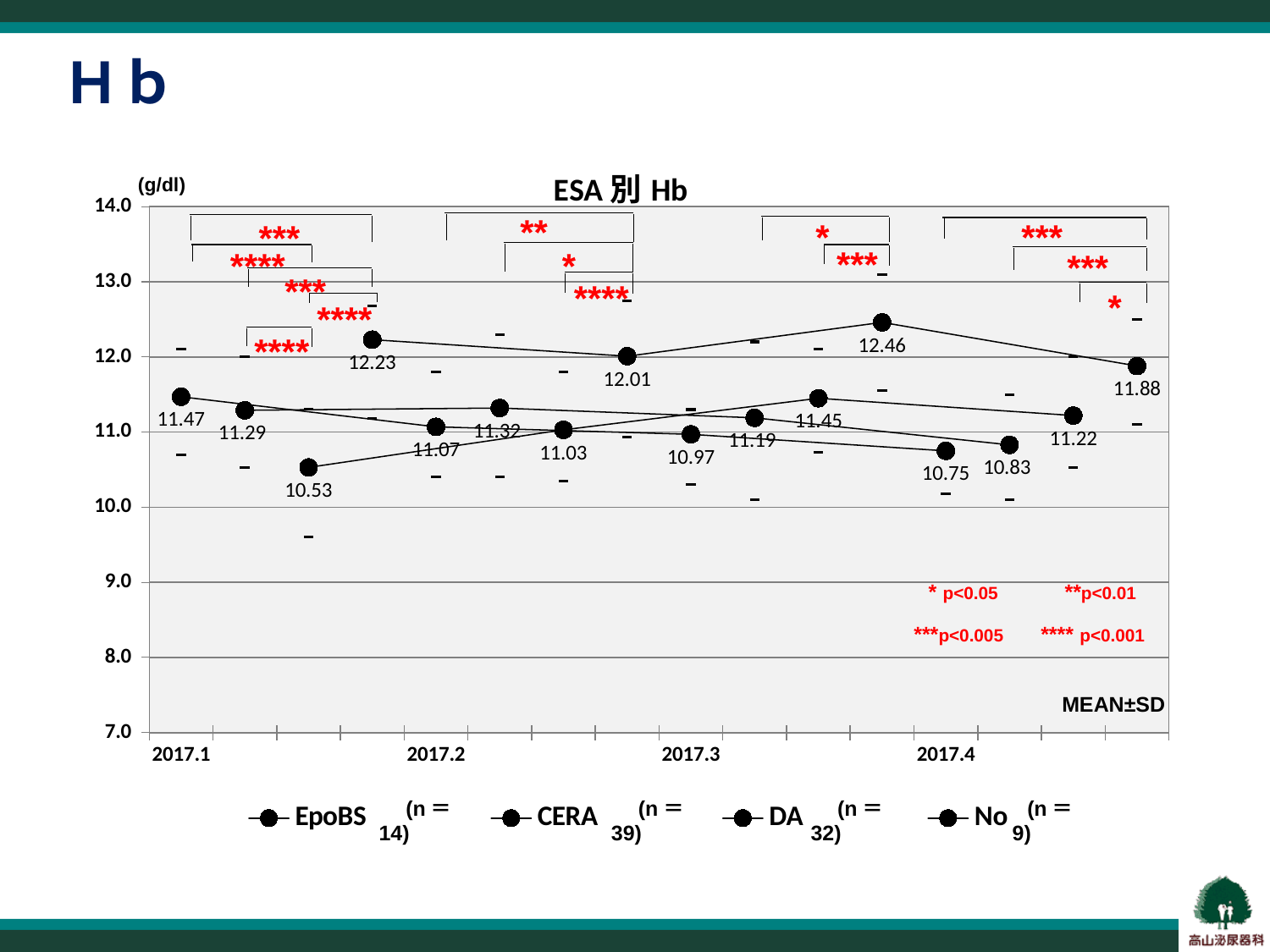
Does the topmost line rise or fall from 2017.3 to 2017.4? fall Is the lowest labelled value in the 2017.1 period greater or less than 11.0? less How many series does the legend list? 4 What is the lowest data value labelled on the chart? 10.53 What is the title of the chart? ESA 別 Hb What kind of chart is shown on the slide? line chart What is the highest data value labelled on the chart? 12.46 What is the highest labelled value in the 2017.4 period? 11.88 Which is larger, the highest labelled value in 2017.1 (12.23) or the highest labelled value in 2017.2 (12.01)? 12.23 What is the difference between the highest labelled value in 2017.3 (12.46) and the highest labelled value in 2017.4 (11.88)? 0.58 According to the legend, what is the n for the CERA series? 39 How many time periods are labelled on the x axis? 4